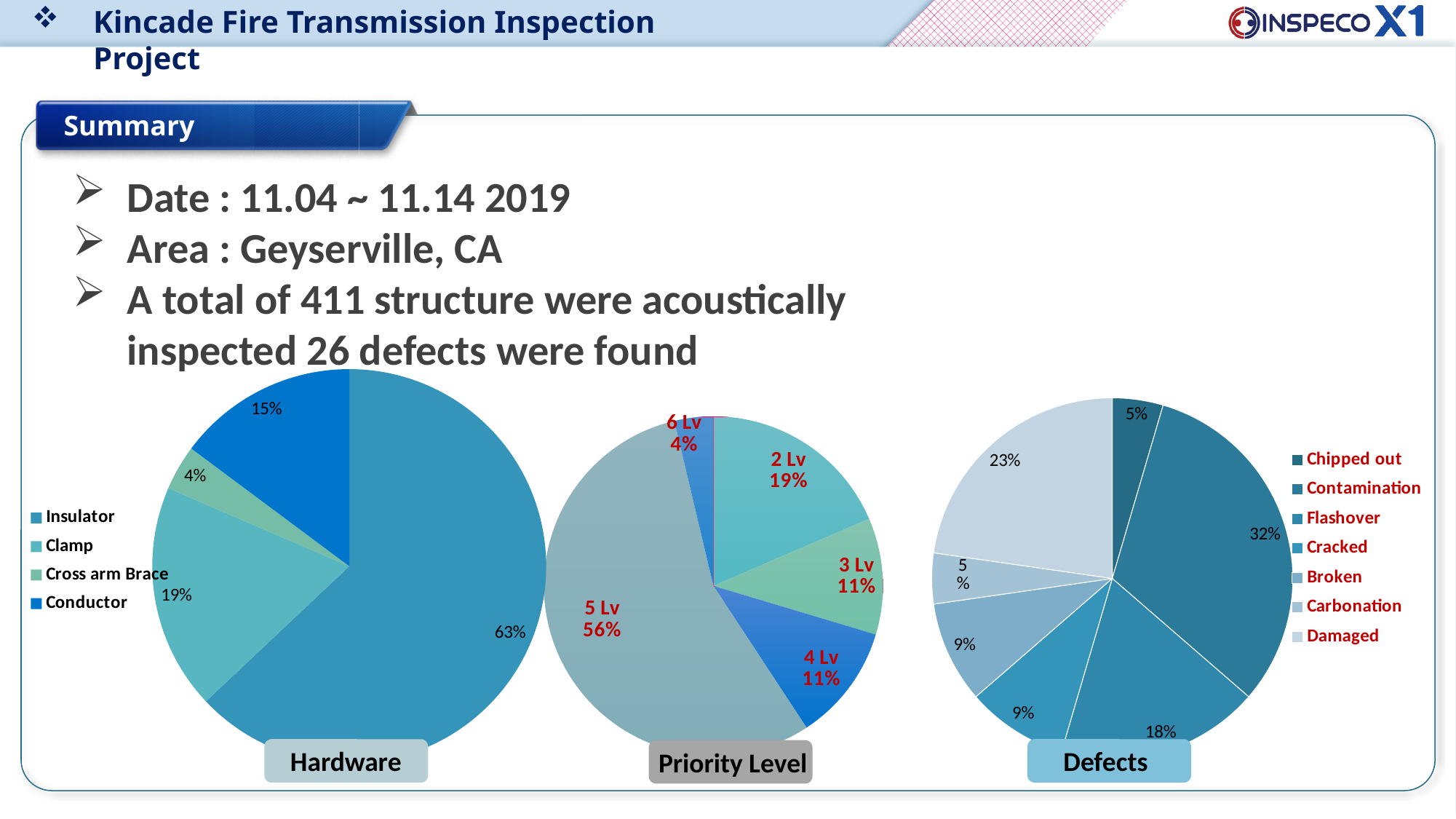
In the Hardware pie chart, what is the difference between the Clamp share and the Conductor share? 4% In the Priority Level pie chart, which priority level has the smallest share? 6 Lv In the Defects pie chart, which defect type has the largest share? Contamination In the Priority Level pie chart, what share is labelled for 5 Lv? 56% In the Hardware pie chart, which hardware category has the smallest share? Cross arm Brace How many defect types does the Defects chart's legend list? 7 In the Priority Level pie chart, which is larger, the share for 2 Lv or the share for 3 Lv? 2 Lv In the Defects pie chart, what share is labelled for Contamination? 32% What type of chart is used for the Defects chart? Pie chart How many slices does the Priority Level pie chart have? 5 In the Hardware pie chart, what share is labelled for the Insulator slice? 63% How many categories does the Hardware pie chart's legend list? 4